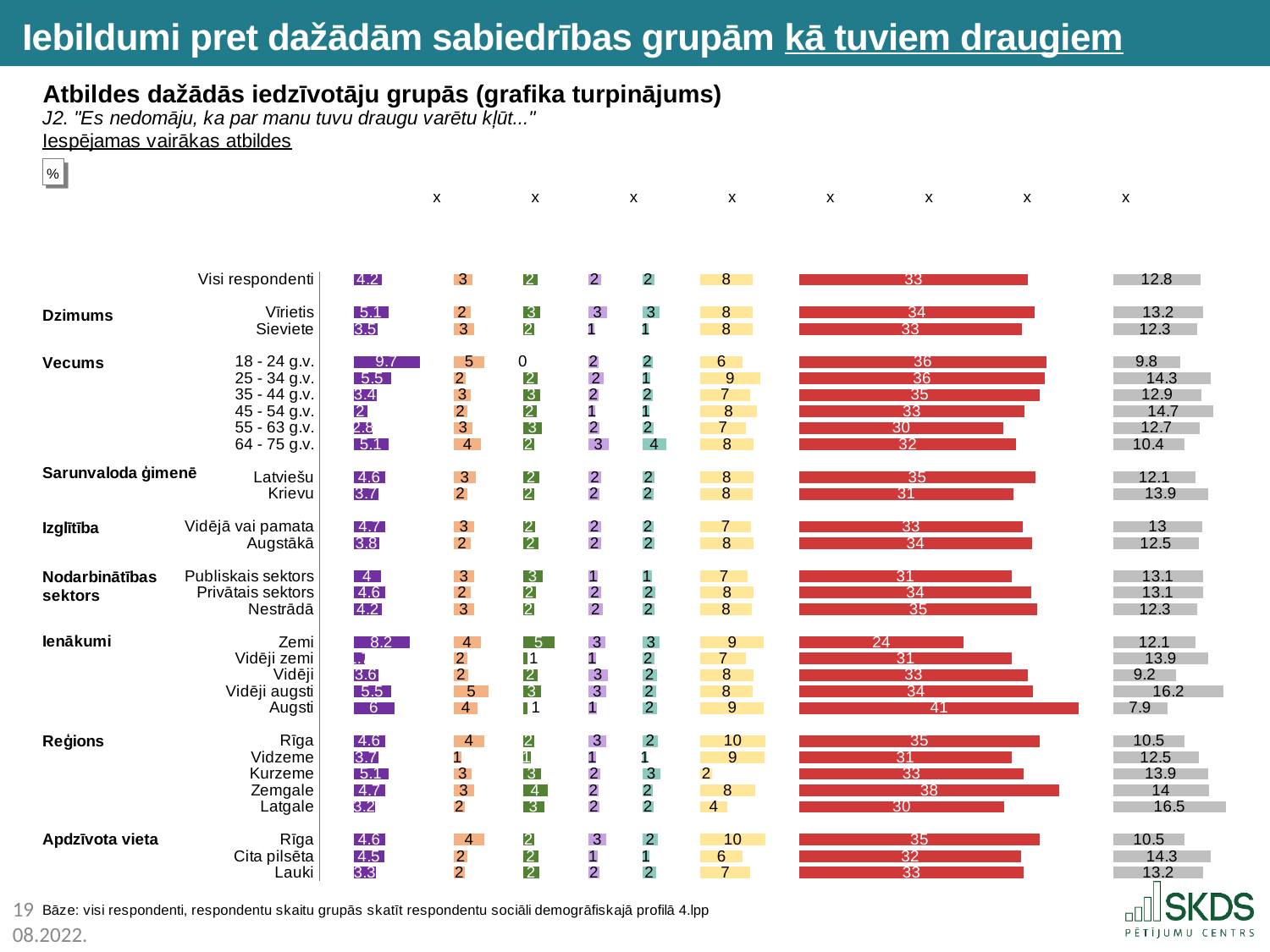
How many age groups are listed under Vecums? 6 In the red bar column, what is the value for Visi respondenti? 33 In the rightmost grey bar column, what is the value for Visi respondenti? 12.8 In the rightmost grey bar column, which row has the highest value? Latgale In the first (dark purple) bar column, what is the value for the 18 - 24 g.v. group? 9.7 In the yellow bar column, what is the value for Rīga under Reģions? 10 In the red bar column, which row has the highest value? Augsti In the red bar column, what is the difference between Vīrietis and Sieviete? 1 In the red bar column, which is larger: Zemgale or Latgale? Zemgale In the red bar column, which row has the lowest value? Zemi In the rightmost grey bar column, which row has the lowest value? Augsti What kind of chart is shown on the slide? bar chart